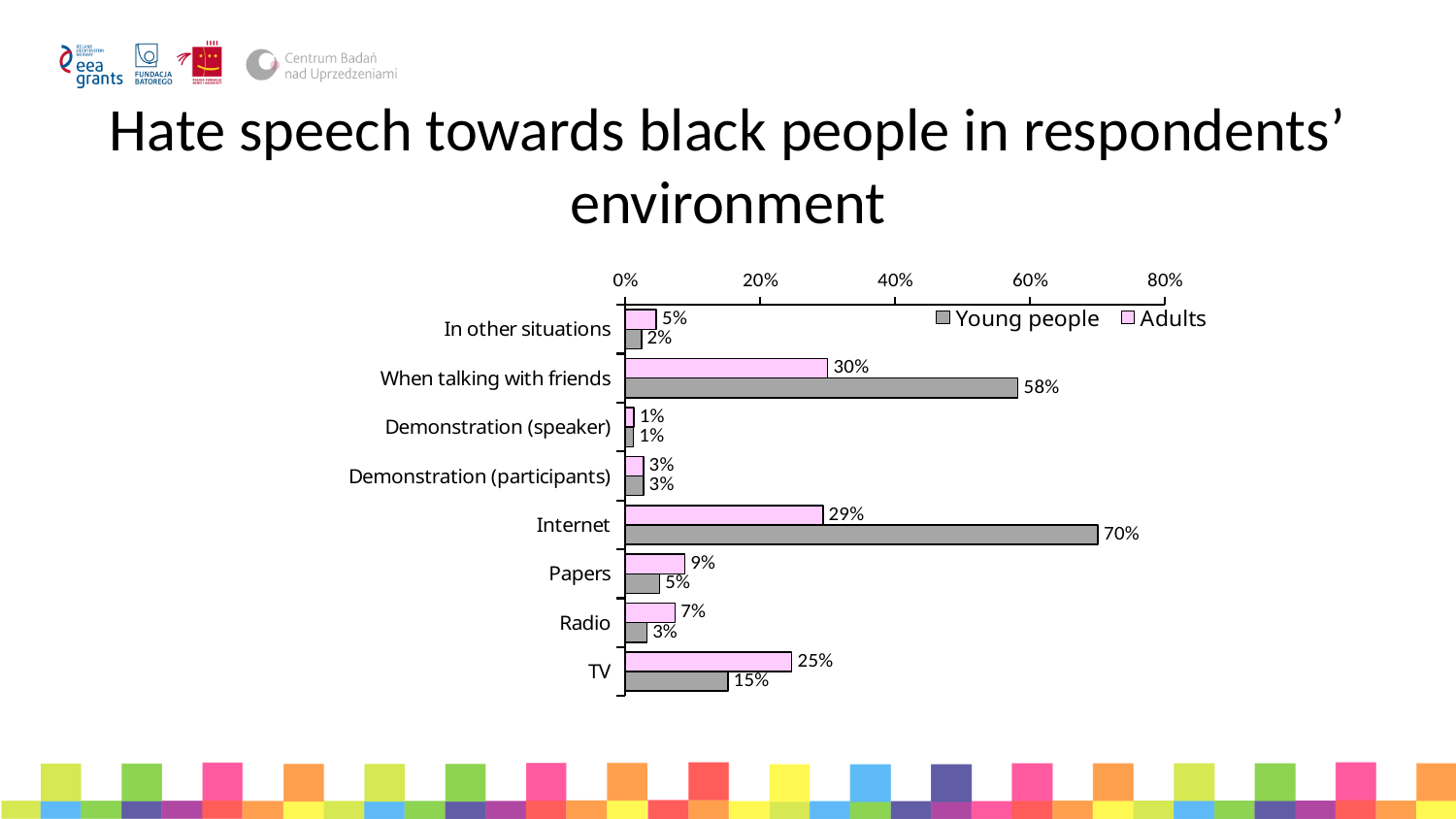
How many series does the legend list? 2 Which group has the larger value for Papers, young people or adults? Adults What is the difference between young people and adults for the Internet category? 41% What percentage of adults reported hate speech towards black people when talking with friends? 30% What is the value for adults in the TV category? 25% What type of chart is shown on the slide? Bar chart How many categories are shown on the chart? 8 Which group has the larger value for When talking with friends, young people or adults? Young people In which category is the value for adults lowest? Demonstration (speaker) What percentage of young people reported hate speech towards black people on the Internet? 70% In which category is the value for young people highest? Internet What is the difference between adults and young people for TV? 10%